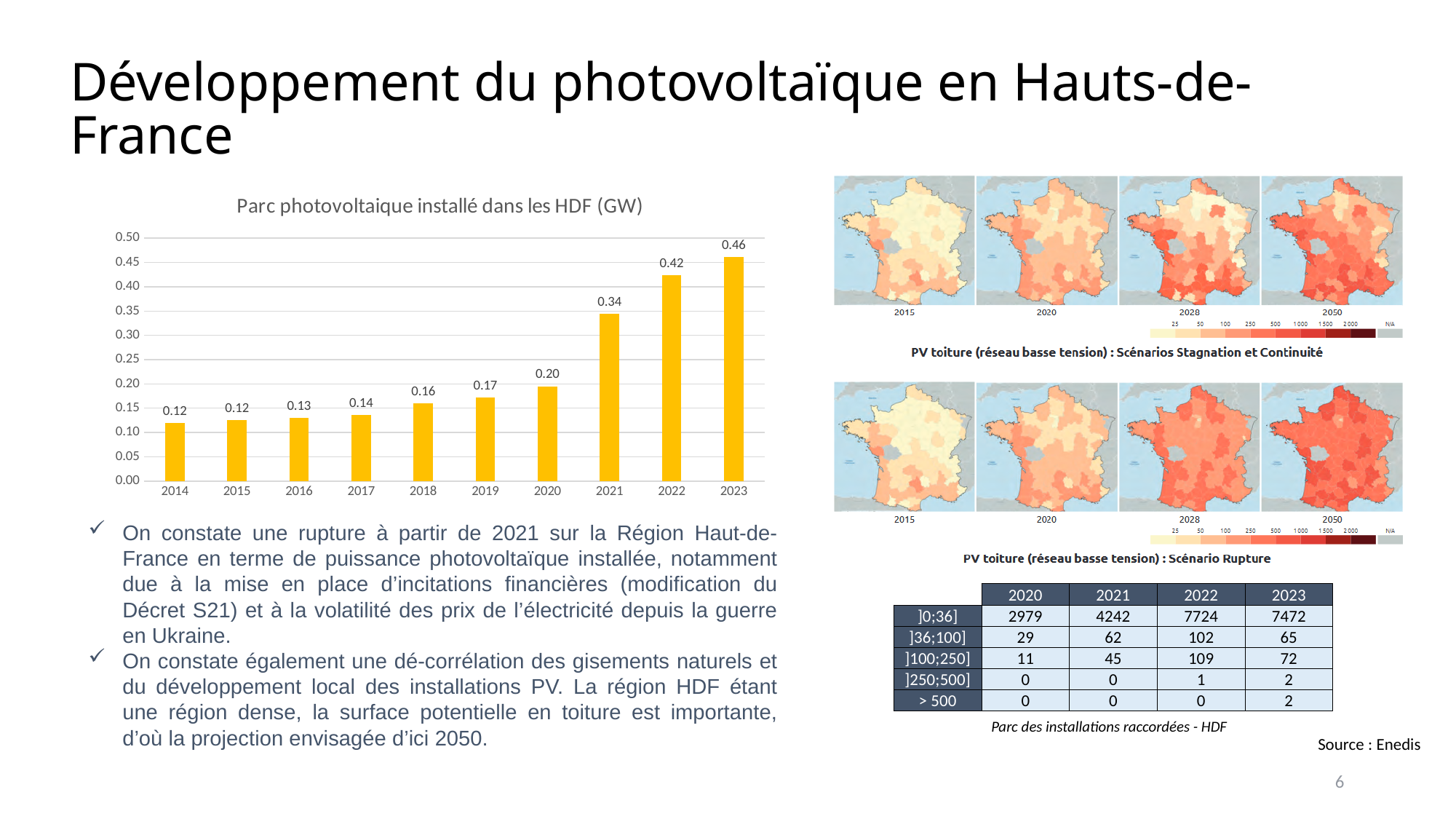
What is the difference between the values for 2023 and 2022 in the chart 'Parc photovoltaique installé dans les HDF (GW)'? 0.04 What is the value for 2017 in the chart 'Parc photovoltaique installé dans les HDF (GW)'? 0.14 What is the difference between the values for 2021 and 2020 in the chart 'Parc photovoltaique installé dans les HDF (GW)'? 0.14 What is the value for 2020 in the chart 'Parc photovoltaique installé dans les HDF (GW)'? 0.20 In the chart 'Parc photovoltaique installé dans les HDF (GW)', which is larger, the value for 2019 or the value for 2021? 2021 What is the value for 2023 in the chart 'Parc photovoltaique installé dans les HDF (GW)'? 0.46 In the chart 'Parc photovoltaique installé dans les HDF (GW)', is the value for 2022 greater or less than 0.40? greater Which year has the highest value in the chart 'Parc photovoltaique installé dans les HDF (GW)'? 2023 How many years are shown on the x axis of the chart 'Parc photovoltaique installé dans les HDF (GW)'? 10 Do the values in the chart 'Parc photovoltaique installé dans les HDF (GW)' rise or fall from 2014 to 2023? rise What is the title of the bar chart on the left of the slide? Parc photovoltaique installé dans les HDF (GW) What kind of chart is 'Parc photovoltaique installé dans les HDF (GW)'? bar chart